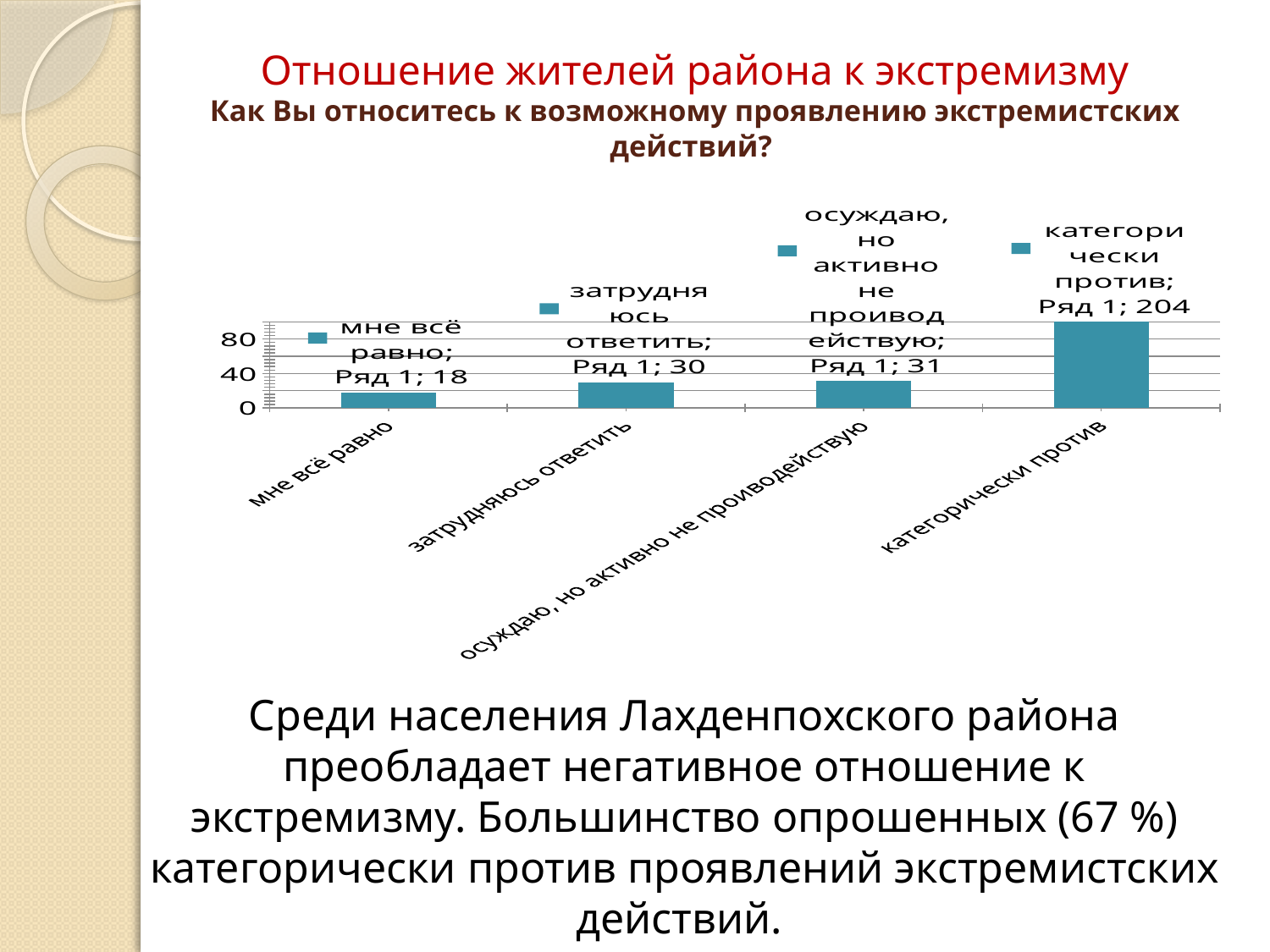
What is the value for the category "затрудняюсь ответить"? 30 What is the value for the category "осуждаю, но активно не проиводействую"? 31 Which is larger: the value for "затрудняюсь ответить" or the value for "мне всё равно"? затрудняюсь ответить What type of chart is shown on the slide? bar chart What is the difference between the values for "категорически против" and "мне всё равно"? 186 Which category has the lowest value? мне всё равно Which category has the highest value? категорически против How many categories are plotted in the chart? 4 What is the value for the category "мне всё равно"? 18 What series name is shown in the data labels of the chart? Ряд 1 What is the value for the category "категорически против"? 204 Is the value for "категорически против" greater or less than 80? greater